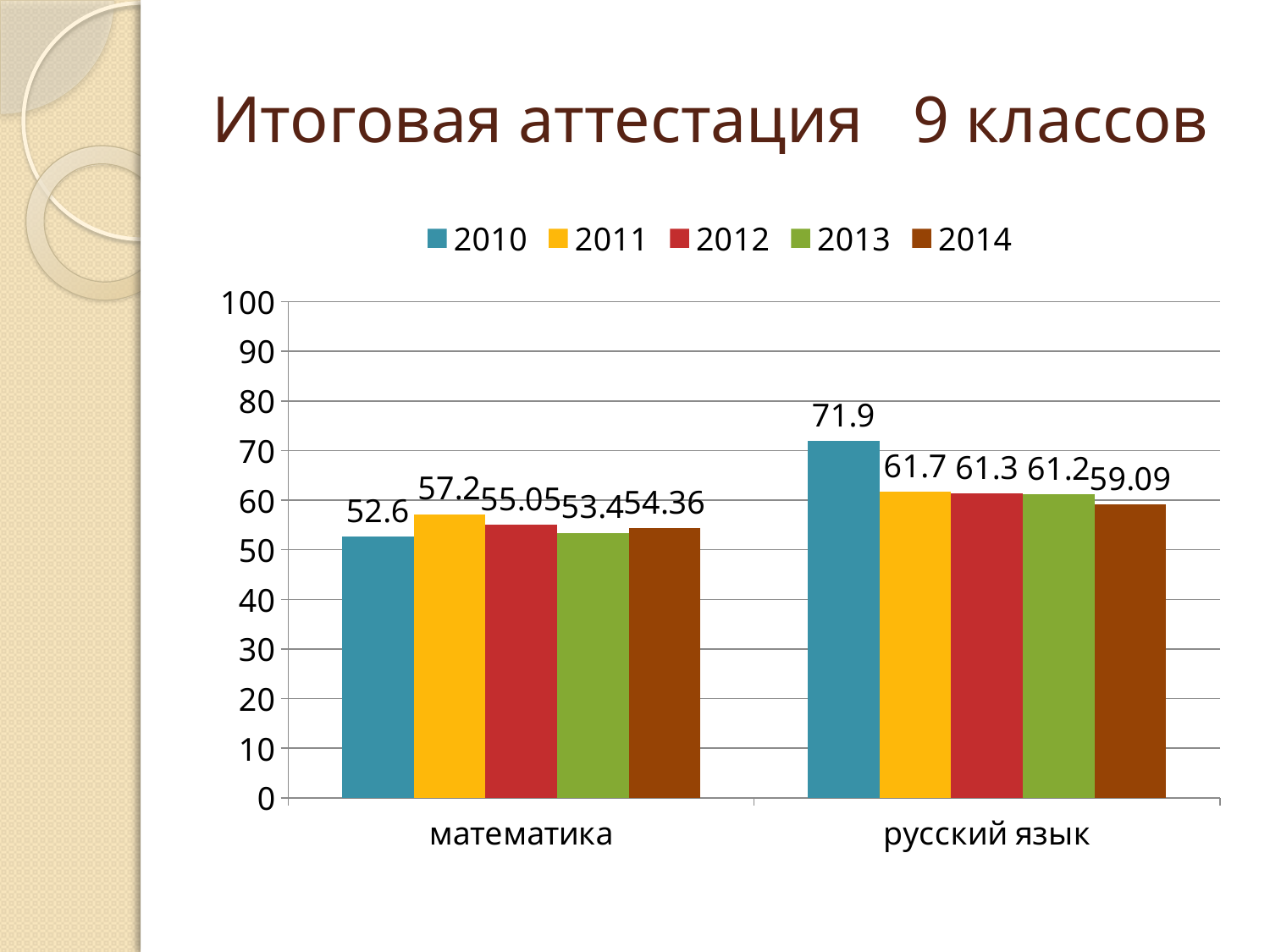
How many series does the legend list? 5 Which year has the highest value in the русский язык category? 2010 Which year has the lowest value in the математика category? 2010 What kind of chart is shown on the slide? bar chart What is the title of the slide? Итоговая аттестация 9 классов Is the 2010 value for русский язык greater or less than 70? greater What is the difference between the 2010 values for русский язык and математика? 19.3 What is the value for 2012 in the математика category? 55.05 What is the value for 2014 in the русский язык category? 59.09 Which is larger: the 2011 value for математика or the 2011 value for русский язык? русский язык How many categories are shown on the x axis? 2 What is the value for 2010 in the математика category? 52.6